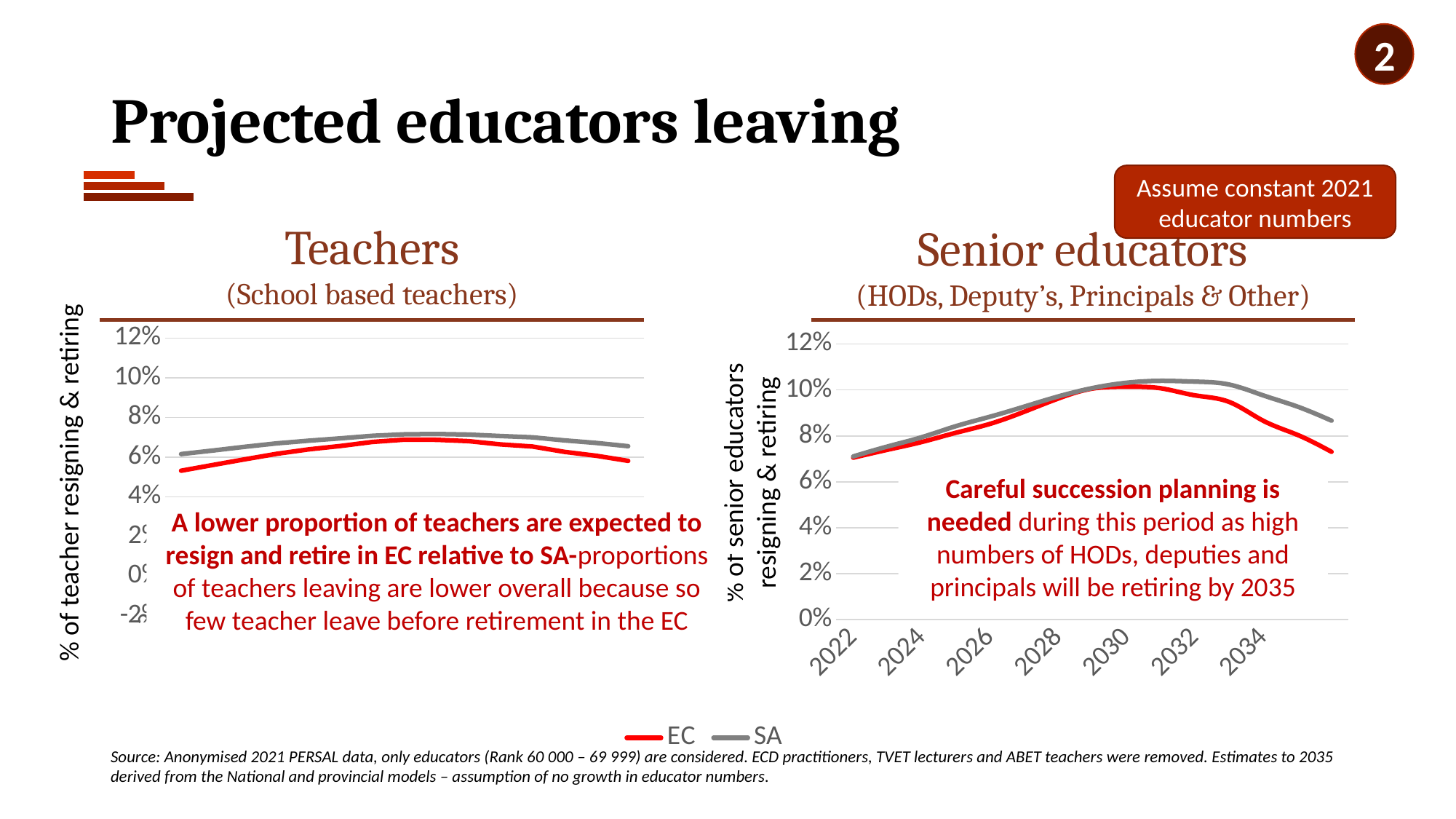
In the Senior educators chart, which series is higher in 2034, EC or SA? SA In the Senior educators chart, is the peak SA value greater or less than 10%? greater How many year labels are shown on the x axis of the Senior educators chart? 7 In the Teachers chart, is the highest SA value greater or less than 8%? less What is the subtitle under the Senior educators chart title? (HODs, Deputy's, Principals & Other) What are the two series named in the legend? EC and SA How many series does the legend list for the charts? 2 In the Senior educators chart, does the EC line rise or fall between 2022 and 2030? rise In the Senior educators chart, is the EC value in 2022 greater or less than 6%? greater In the Teachers chart, which series is higher across the whole period, EC or SA? SA What kind of chart is the Teachers chart? line chart